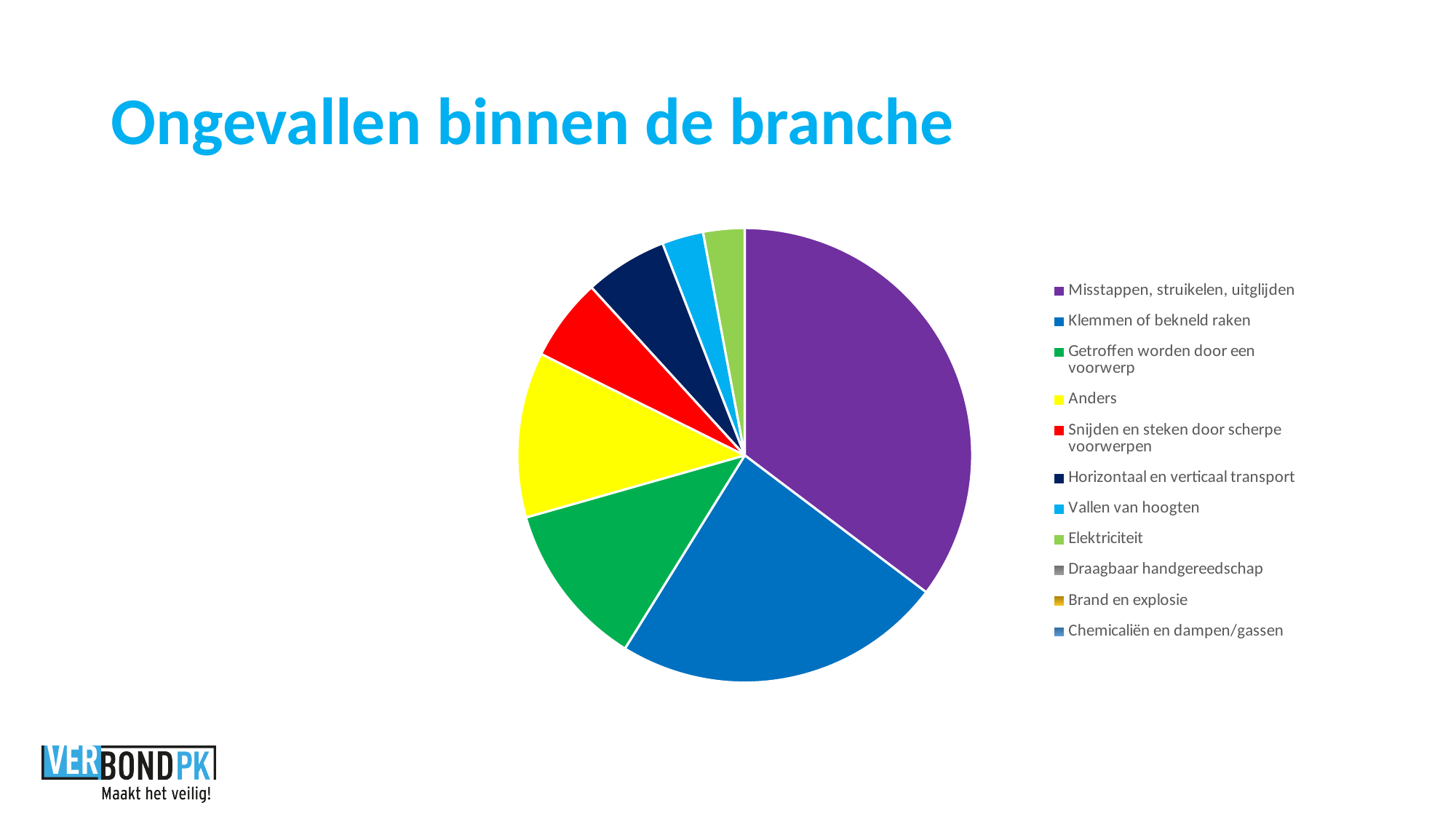
Which category has the largest slice of the pie? Misstappen, struikelen, uitglijden Which slice is larger: Getroffen worden door een voorwerp or Vallen van hoogten? Getroffen worden door een voorwerp Which slice is larger: Snijden en steken door scherpe voorwerpen or Elektriciteit? Snijden en steken door scherpe voorwerpen How many categories does the legend list? 11 Which slice is larger: Klemmen of bekneld raken or Getroffen worden door een voorwerp? Klemmen of bekneld raken What is the title of the slide containing the pie chart? Ongevallen binnen de branche What kind of chart is shown on the slide? Pie chart What colour is the slice for Anders? Yellow